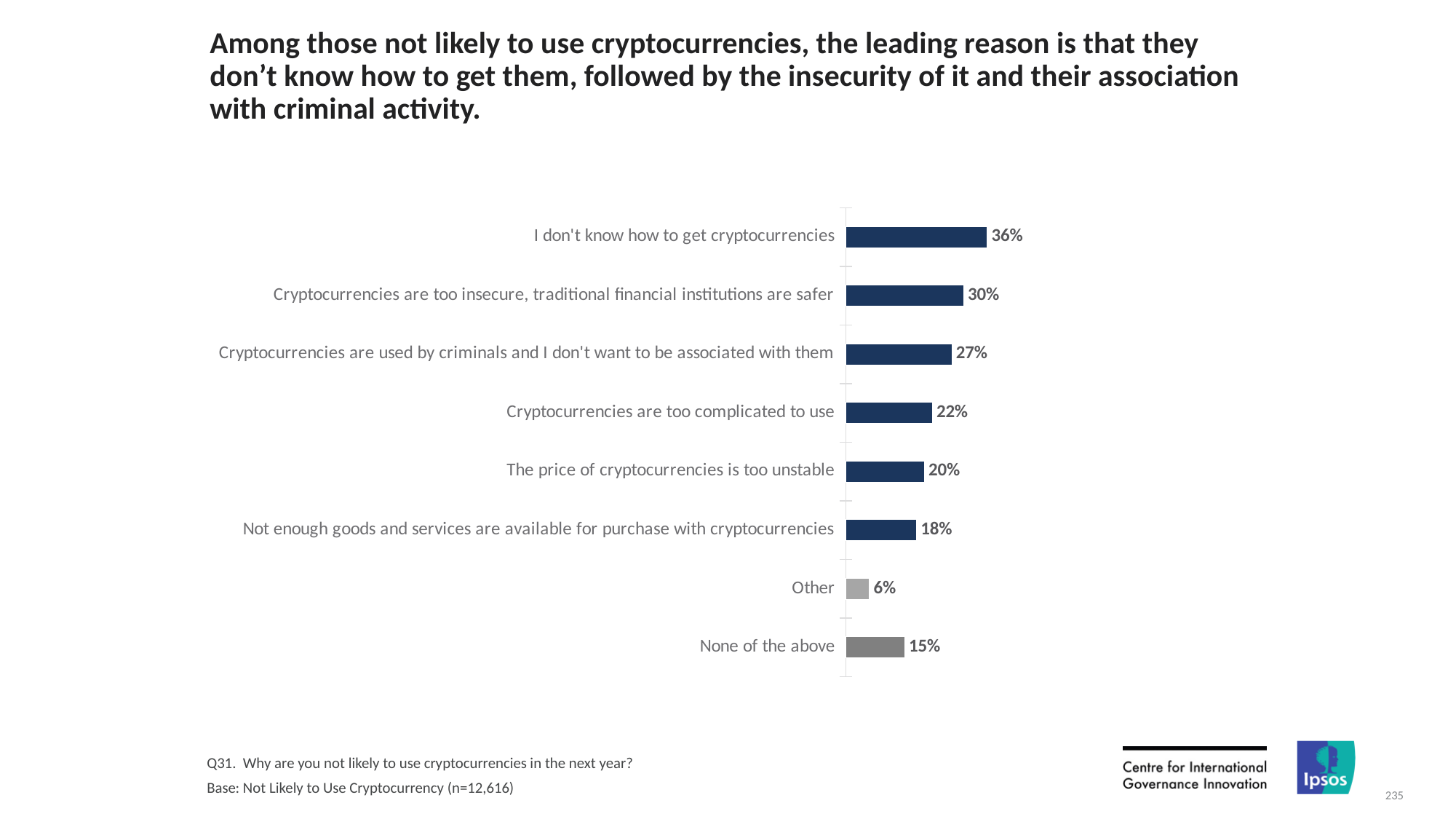
What percentage of respondents said "I don't know how to get cryptocurrencies"? 36% How many categories are shown in the chart? 8 What kind of chart is shown on the slide? Bar chart What is the value for "Cryptocurrencies are too complicated to use"? 22% What is the difference between "I don't know how to get cryptocurrencies" and "Other"? 30% Which bars are shown in grey rather than dark blue? Other and None of the above Which reason has the highest percentage? I don't know how to get cryptocurrencies Which category has the lowest percentage? Other Which is larger: "Cryptocurrencies are used by criminals and I don't want to be associated with them" or "Not enough goods and services are available for purchase with cryptocurrencies"? Cryptocurrencies are used by criminals and I don't want to be associated with them What percentage chose "None of the above"? 15% What is the difference between "Cryptocurrencies are too insecure, traditional financial institutions are safer" and "Cryptocurrencies are too complicated to use"? 8% What is the value for "The price of cryptocurrencies is too unstable"? 20%